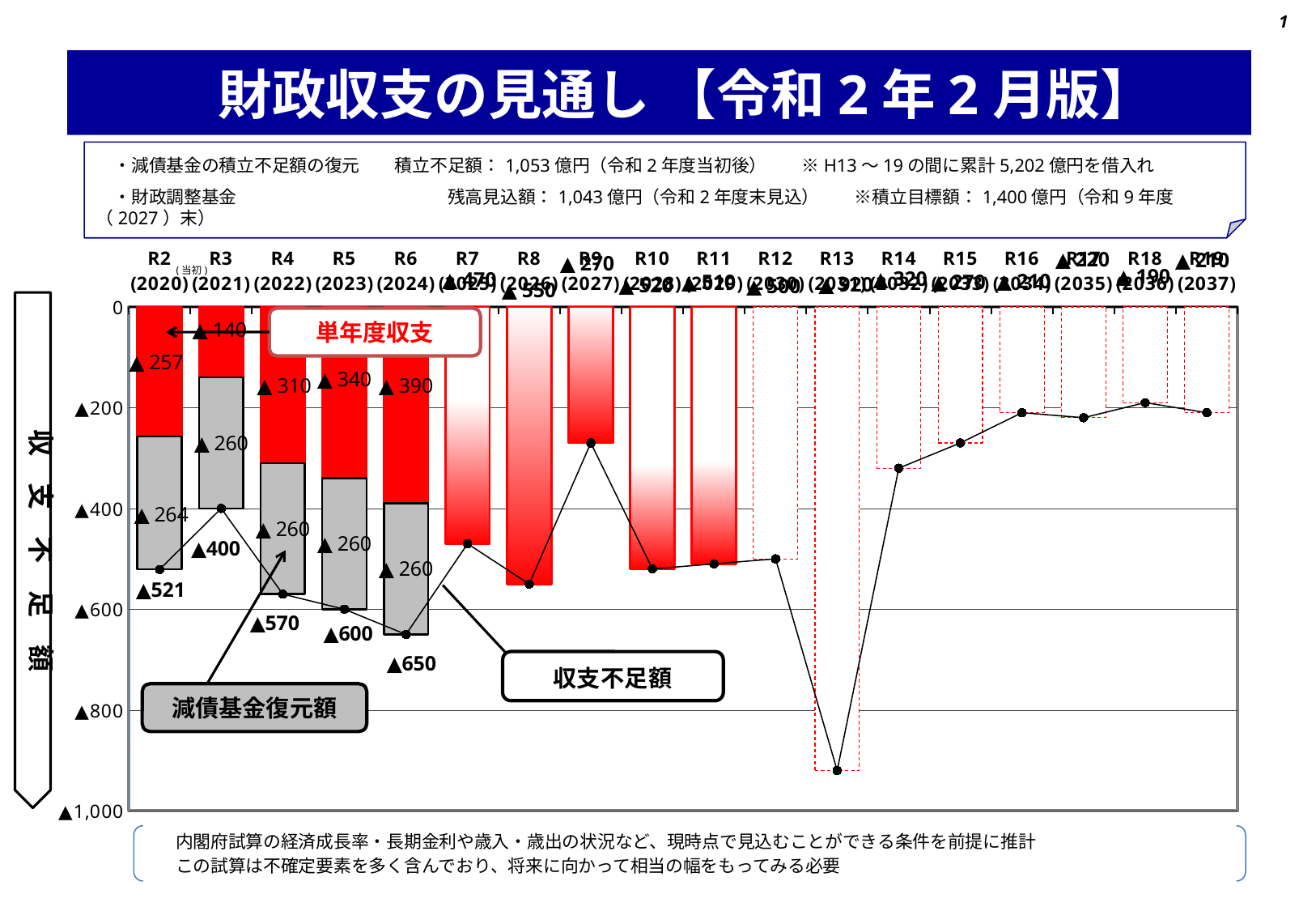
What is the 収支不足額 value for R6 (2024)? ▲650 What is the total of the stacked bar for R4 (2022)? ▲570 What kind of chart is shown on the slide? bar chart with a line Does the 収支不足額 rise or fall from R3 (2021) to R6 (2024)? rises What is the 減債基金復元額 (gray bar) value for R3 (2021)? ▲260 Which year has the largest 収支不足額? R13 (2031) How many fiscal years are shown on the x axis? 18 Which is larger, the 収支不足額 for R8 (2026) or for R9 (2027)? R8 (2026) What is the 単年度収支 (red bar) value for R2 (2020)? ▲257 By how much does the 収支不足額 for R6 (2024) exceed that for R2 (2020)? 129 Which year has the smallest 収支不足額? R18 (2036) What is the 収支不足額 value for R13 (2031)? ▲920